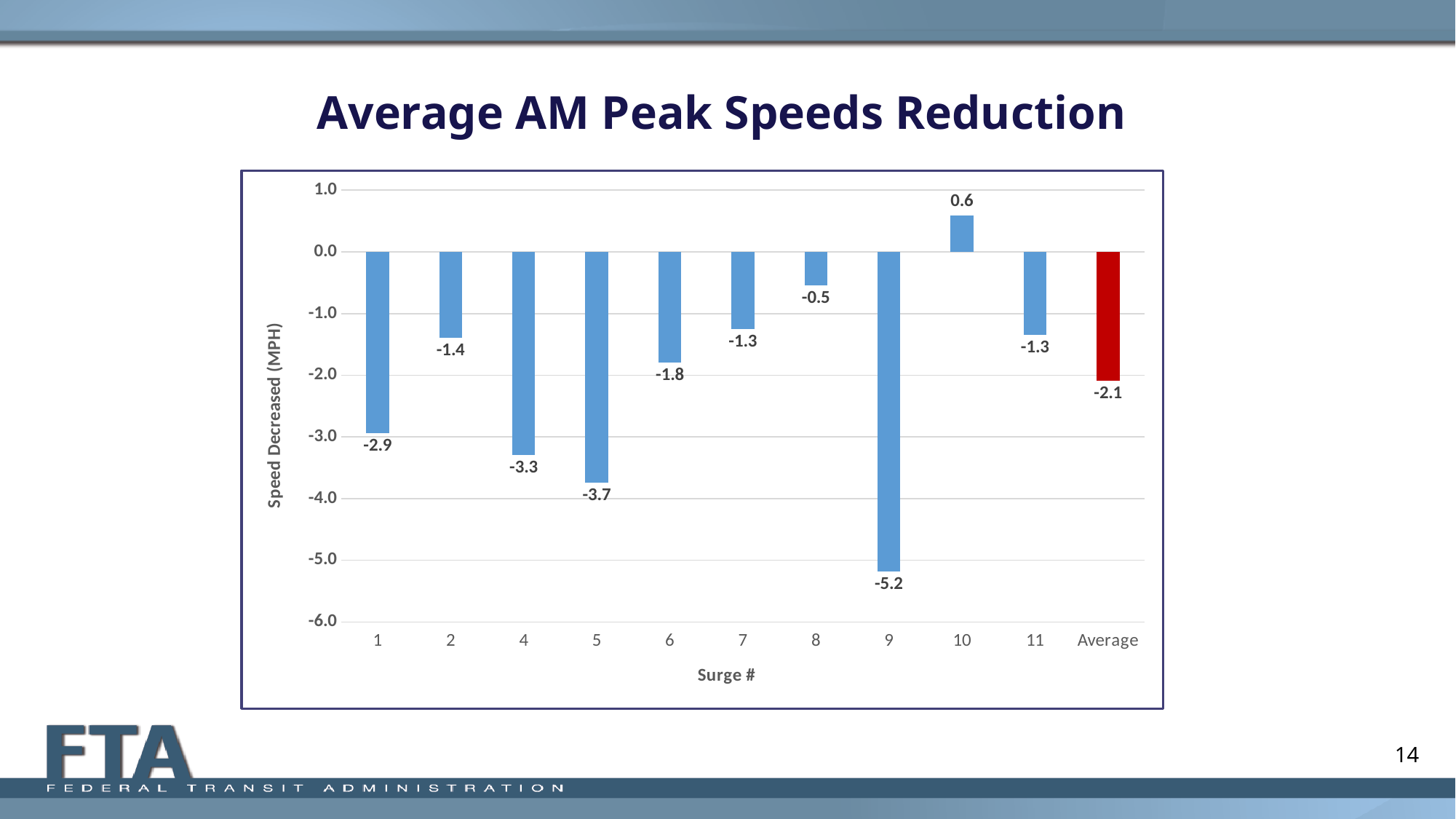
What is the speed decrease value for Surge 9? -5.2 Which surge has the highest value on the chart? 10 How many bars are plotted on the chart, including the Average bar? 11 Which has a larger speed reduction, Surge 1 or Surge 6? Surge 1 Which surge has the largest speed reduction (lowest value)? 9 What is the difference between the values for Surge 5 and Surge 4? 0.4 What is the label of the y axis? Speed Decreased (MPH) Which bar is coloured red instead of blue? Average What is the value for Surge 10? 0.6 What kind of chart is shown on the slide? Bar chart What is the value shown for the Average bar? -2.1 What is the value for Surge 8? -0.5